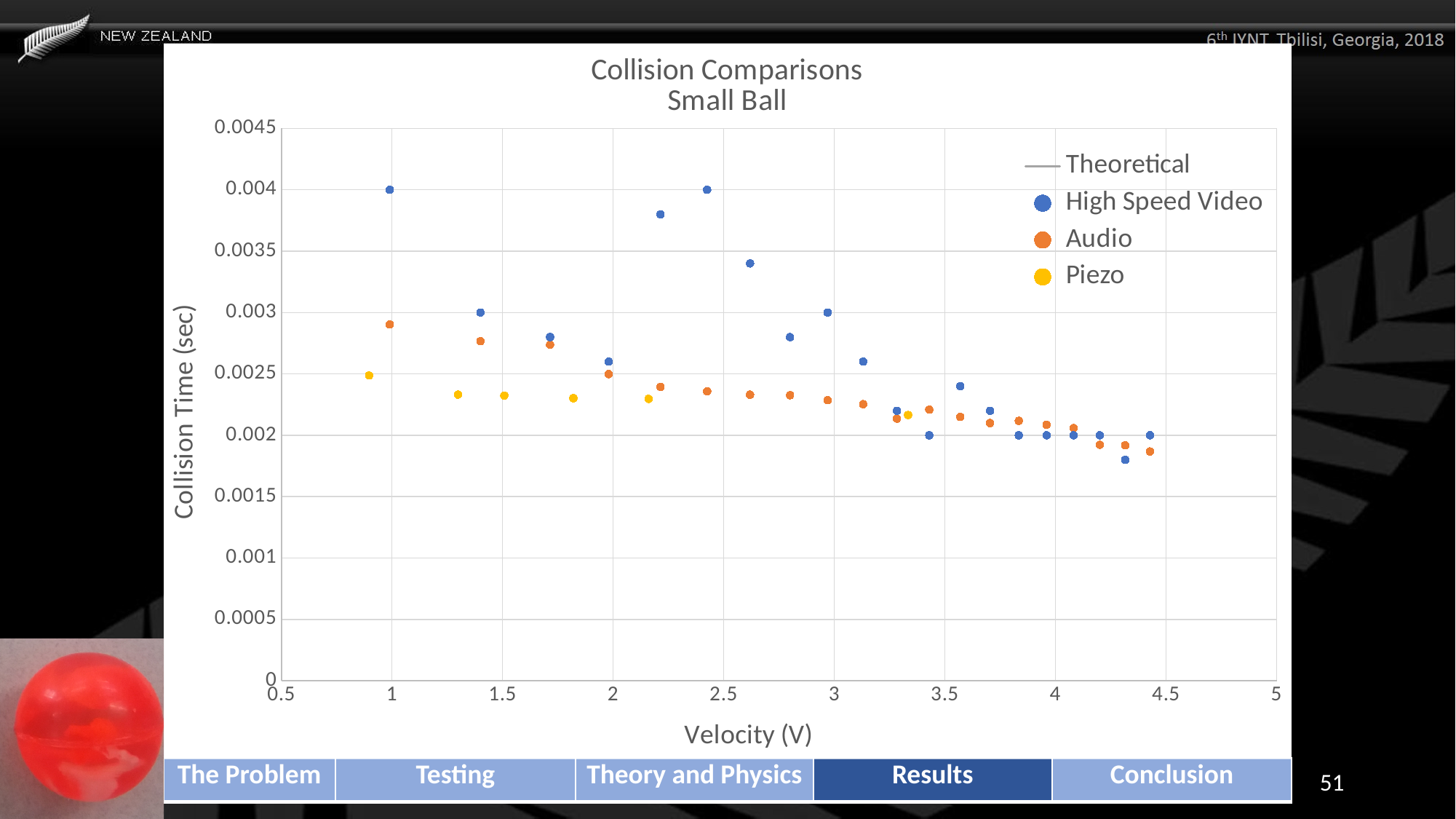
Is the lowest High Speed Video value (near velocity 4.3) greater or less than 0.002? less Is the highest High Speed Video value greater or less than 0.0035? greater How many entries does the legend list? 4 What kind of chart is shown on the slide? Scatter chart Do the High Speed Video collision times generally rise or fall as velocity increases? Fall How many Piezo points are plotted? 6 What colour are the Piezo points in the chart? Yellow Is the Audio value at a velocity of about 1 greater or less than 0.0025? greater What is the title of the chart? Collision Comparisons Small Ball Which series contains the highest plotted collision time? High Speed Video